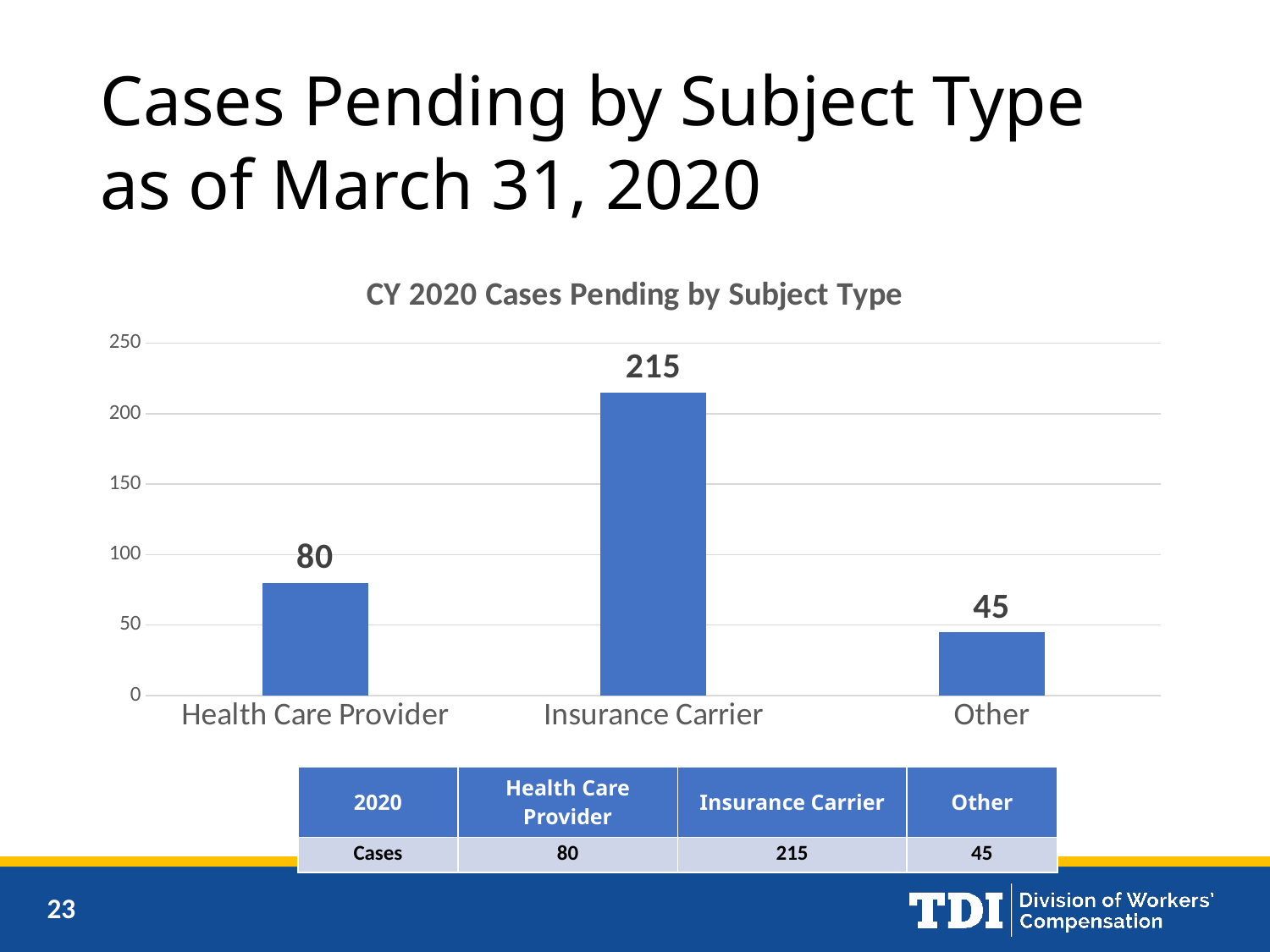
What is the number of cases pending for Health Care Provider? 80 Which subject type has the lowest number of cases pending? Other What is the title of the chart? CY 2020 Cases Pending by Subject Type What kind of chart is shown on the slide? bar chart What is the number of cases pending for Other? 45 Which has more cases pending, Health Care Provider or Other? Health Care Provider How many subject type categories are shown in the chart? 3 What is the difference between the cases pending for Health Care Provider and Other? 35 Is the value for Insurance Carrier greater or less than 200? greater What is the difference between the cases pending for Insurance Carrier and Health Care Provider? 135 What is the number of cases pending for Insurance Carrier? 215 Which subject type has the highest number of cases pending? Insurance Carrier